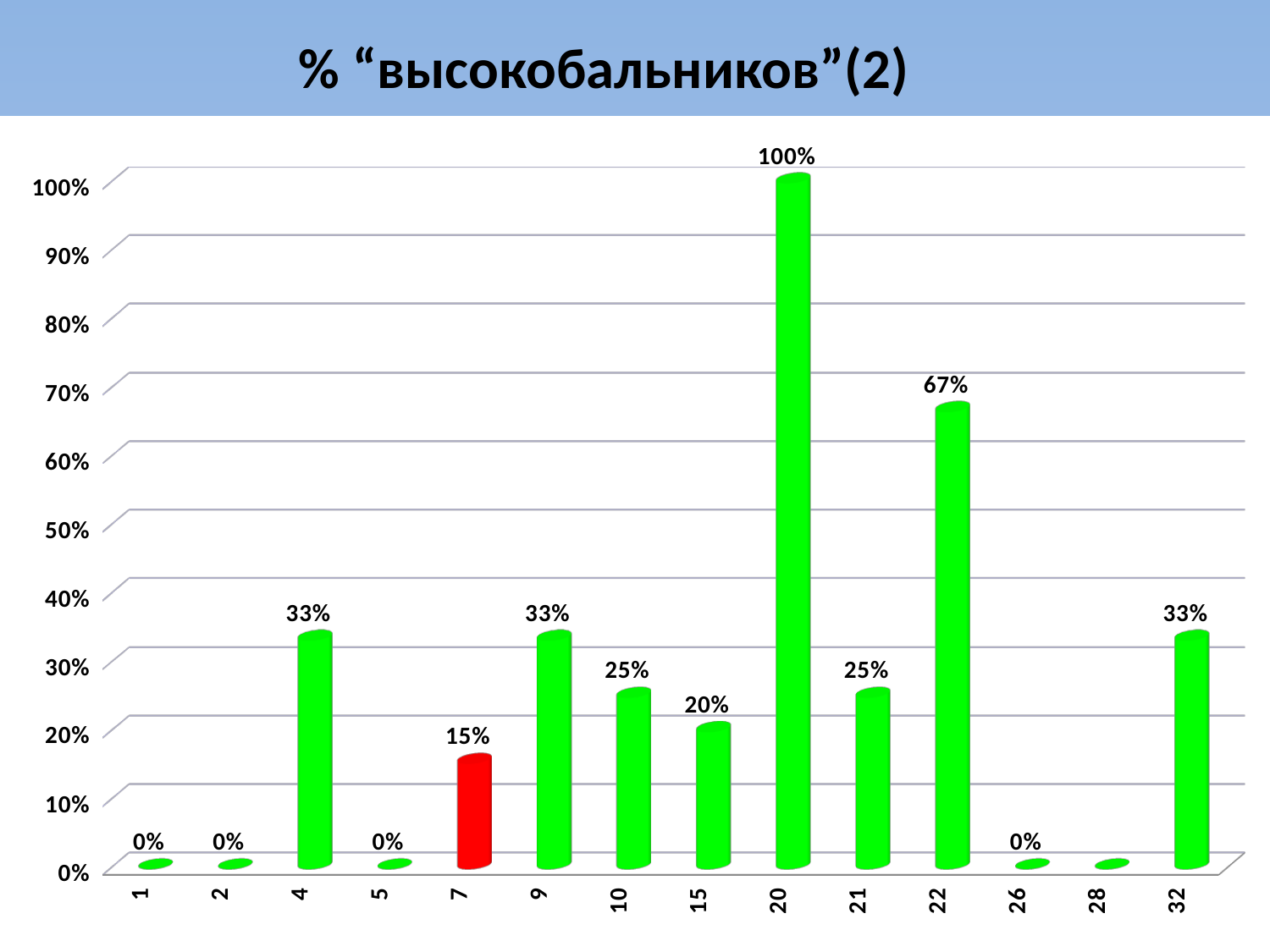
What is the value for category 7? 15% What is the value for category 15? 20% How many categories are shown on the x axis? 14 What is the title of the chart? % "высокобальников"(2) What is the value for category 20? 100% What is the value for category 22? 67% Which has a larger value, category 10 or category 15? 10 What kind of chart is shown on the slide? Bar chart Which category's bar is coloured red? 7 What is the difference between the values for categories 20 and 22? 33% Which category has the highest value? 20 What is the difference between the values for categories 22 and 32? 34%